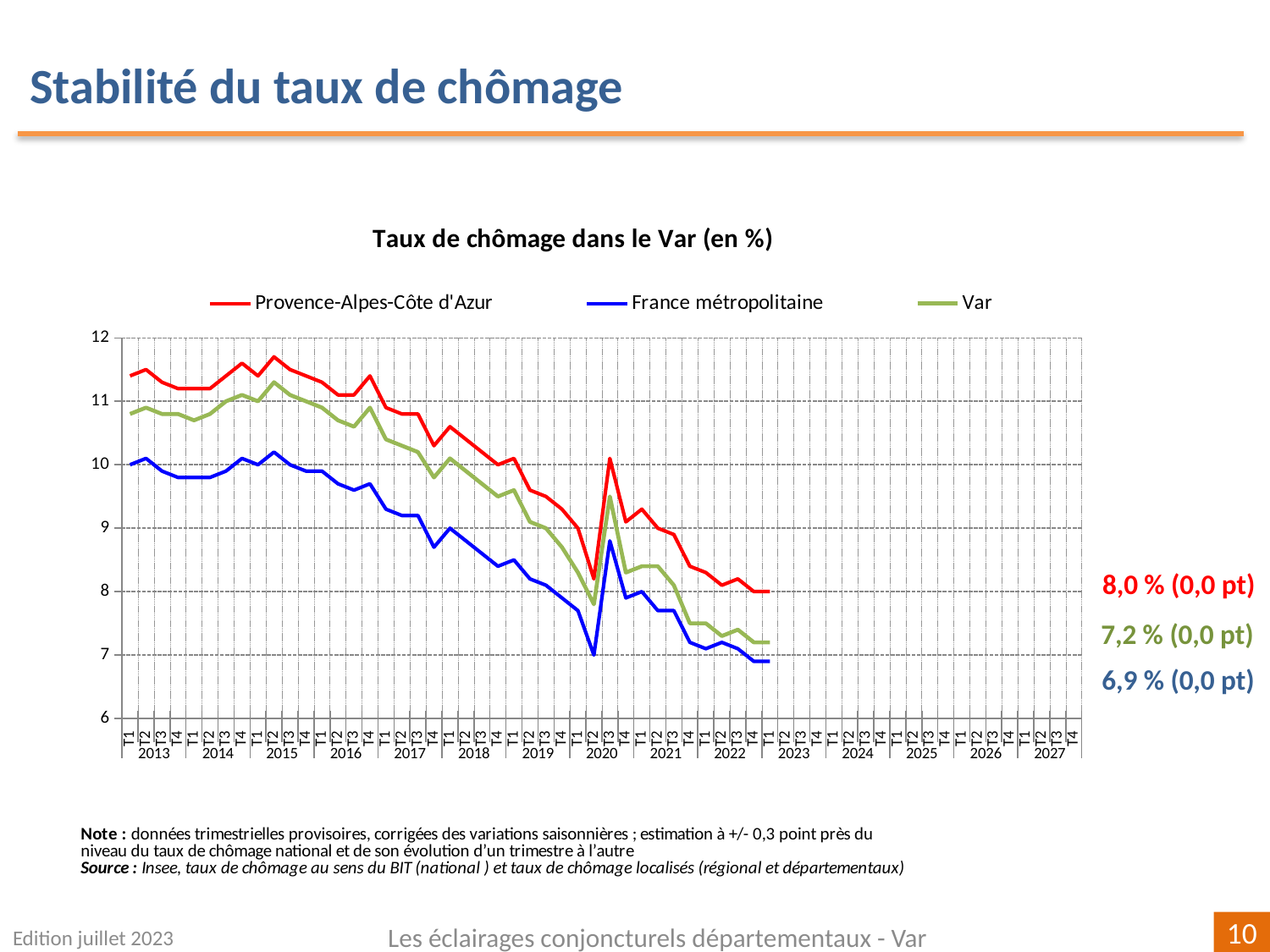
What is the latest value shown for Var? 7,2 % How many series does the legend list? 3 At the end of the plotted period, which is larger: the value for Var or the value for France métropolitaine? Var Which series has the lowest value at the end of the plotted period? France métropolitaine Which series has the highest value at the end of the plotted period? Provence-Alpes-Côte d'Azur Overall, do the unemployment rates rise or fall from 2013 to 2023? fall What is the latest value shown for Provence-Alpes-Côte d'Azur? 8,0 % What kind of chart is shown on the slide? line chart What is the difference between the latest values for Provence-Alpes-Côte d'Azur and France métropolitaine? 1,1 Is the value for Var in T1 2013 greater or less than 10? greater What is the latest value shown for France métropolitaine? 6,9 % What is the title of the chart? Taux de chômage dans le Var (en %)